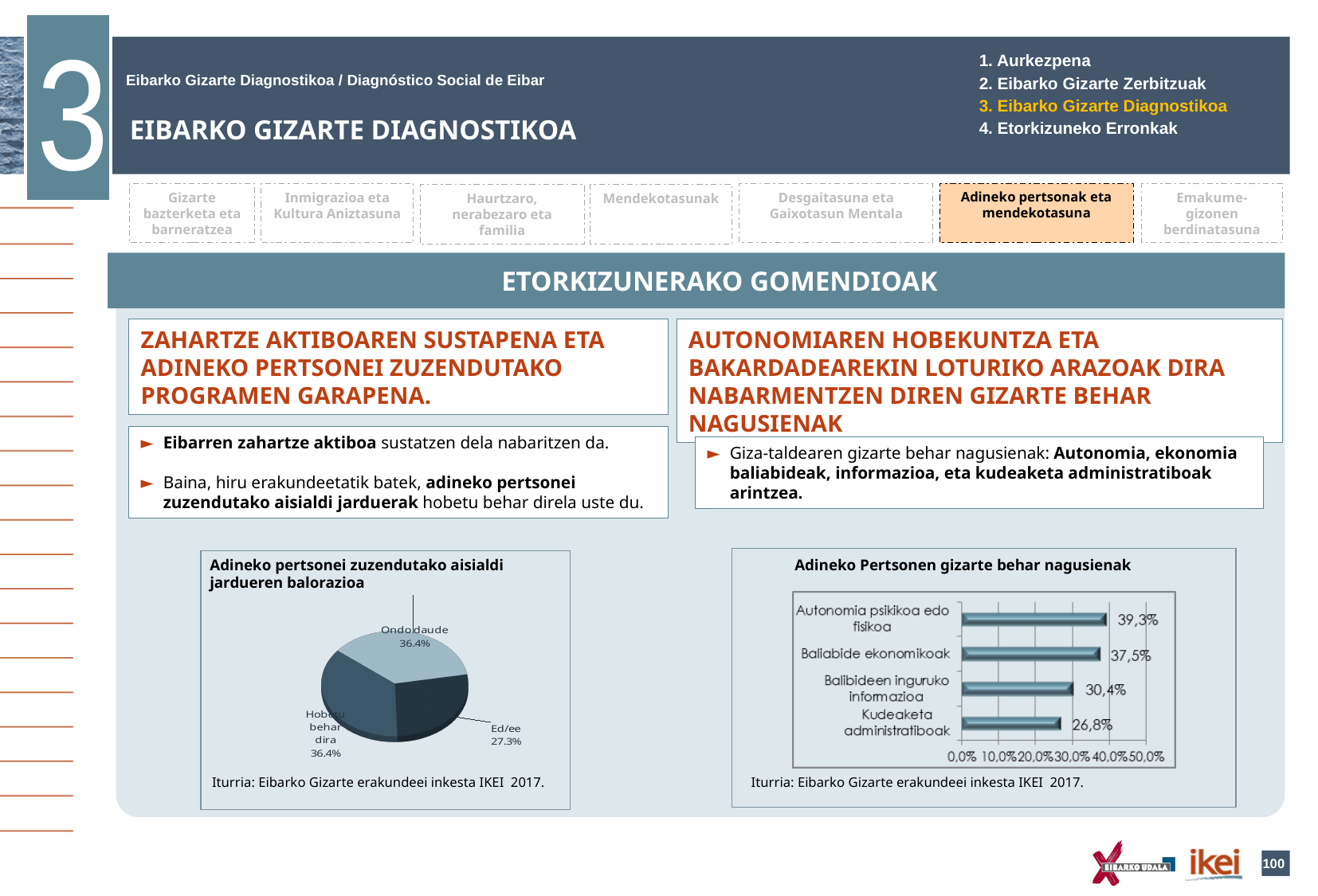
How many slices does the pie chart 'Adineko pertsonei zuzendutako aisialdi jardueren balorazioa' have? 3 In the chart 'Adineko Pertsonen gizarte behar nagusienak', is the value for Balibideen inguruko informazioa greater or less than 40,0%? less In the pie chart 'Adineko pertsonei zuzendutako aisialdi jardueren balorazioa', what share does Ed/ee have? 27.3% In the pie chart 'Adineko pertsonei zuzendutako aisialdi jardueren balorazioa', what is the value for Ondo daude? 36.4% In the chart 'Adineko Pertsonen gizarte behar nagusienak', which category has the lowest value? Kudeaketa administratiboak In the chart 'Adineko Pertsonen gizarte behar nagusienak', which category has the highest value? Autonomia psikikoa edo fisikoa In the chart 'Adineko Pertsonen gizarte behar nagusienak', what is the value for Kudeaketa administratiboak? 26,8% What kind of chart is 'Adineko Pertsonen gizarte behar nagusienak'? Bar chart In the chart 'Adineko Pertsonen gizarte behar nagusienak', what is the value for Autonomia psikikoa edo fisikoa? 39,3% In the chart 'Adineko Pertsonen gizarte behar nagusienak', how many categories are shown? 4 In the pie chart 'Adineko pertsonei zuzendutako aisialdi jardueren balorazioa', which slice is the smallest? Ed/ee In the chart 'Adineko Pertsonen gizarte behar nagusienak', what is the difference between Baliabide ekonomikoak and Balibideen inguruko informazioa? 7,1%